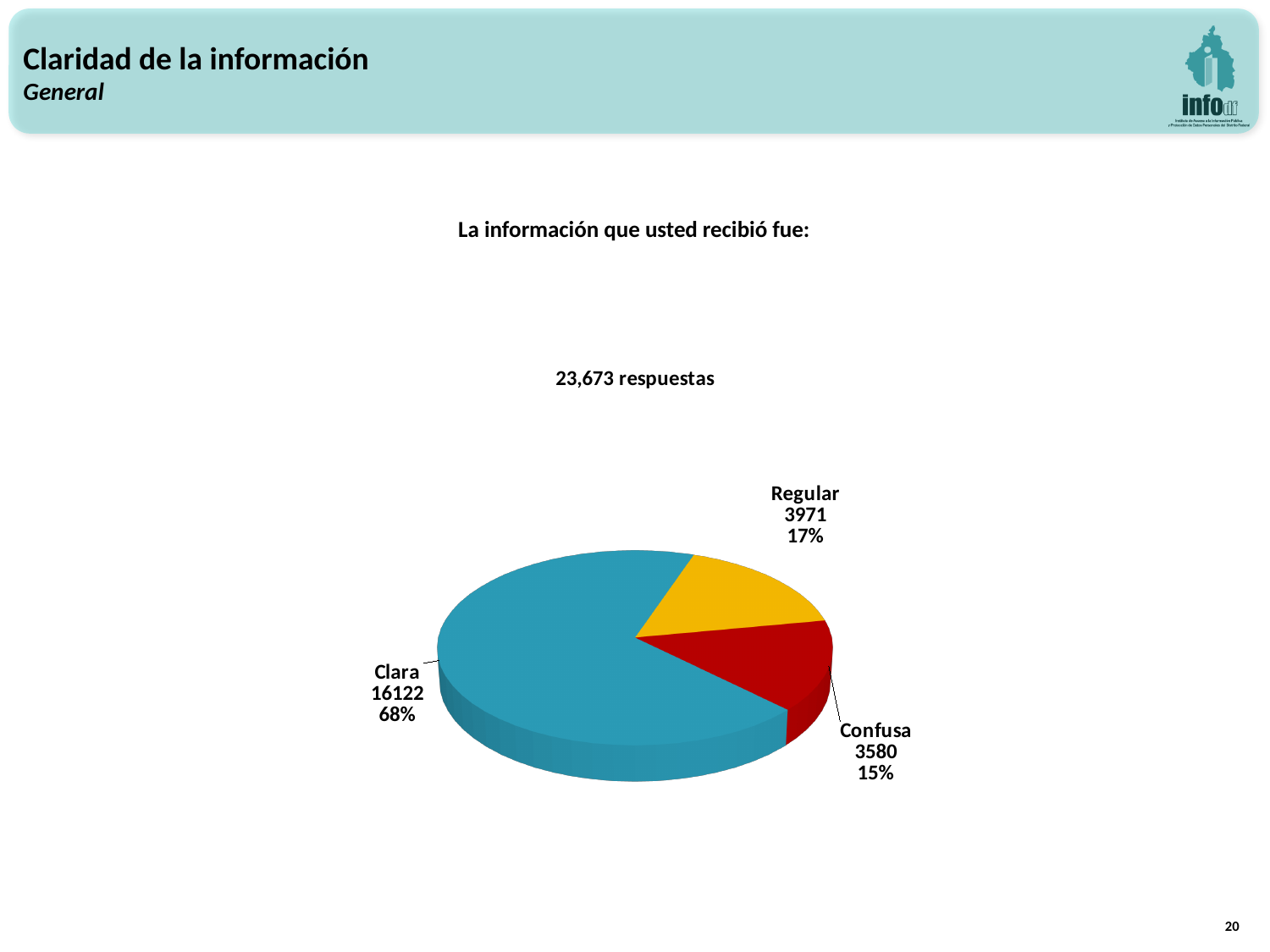
How many slices does the pie chart have? 3 What is the value for Clara? 16122 Which category has the largest slice? Clara What share of the pie does Clara represent? 68% What is the value for Regular? 3971 How many total responses (respuestas) does the slide report? 23,673 respuestas What is the difference between the values for Regular and Confusa? 391 What share of the pie does Confusa represent? 15% Which category has the smallest slice? Confusa What is the value for Confusa? 3580 What kind of chart is shown on the slide? pie chart Which is larger, the value for Clara or the value for Regular? Clara